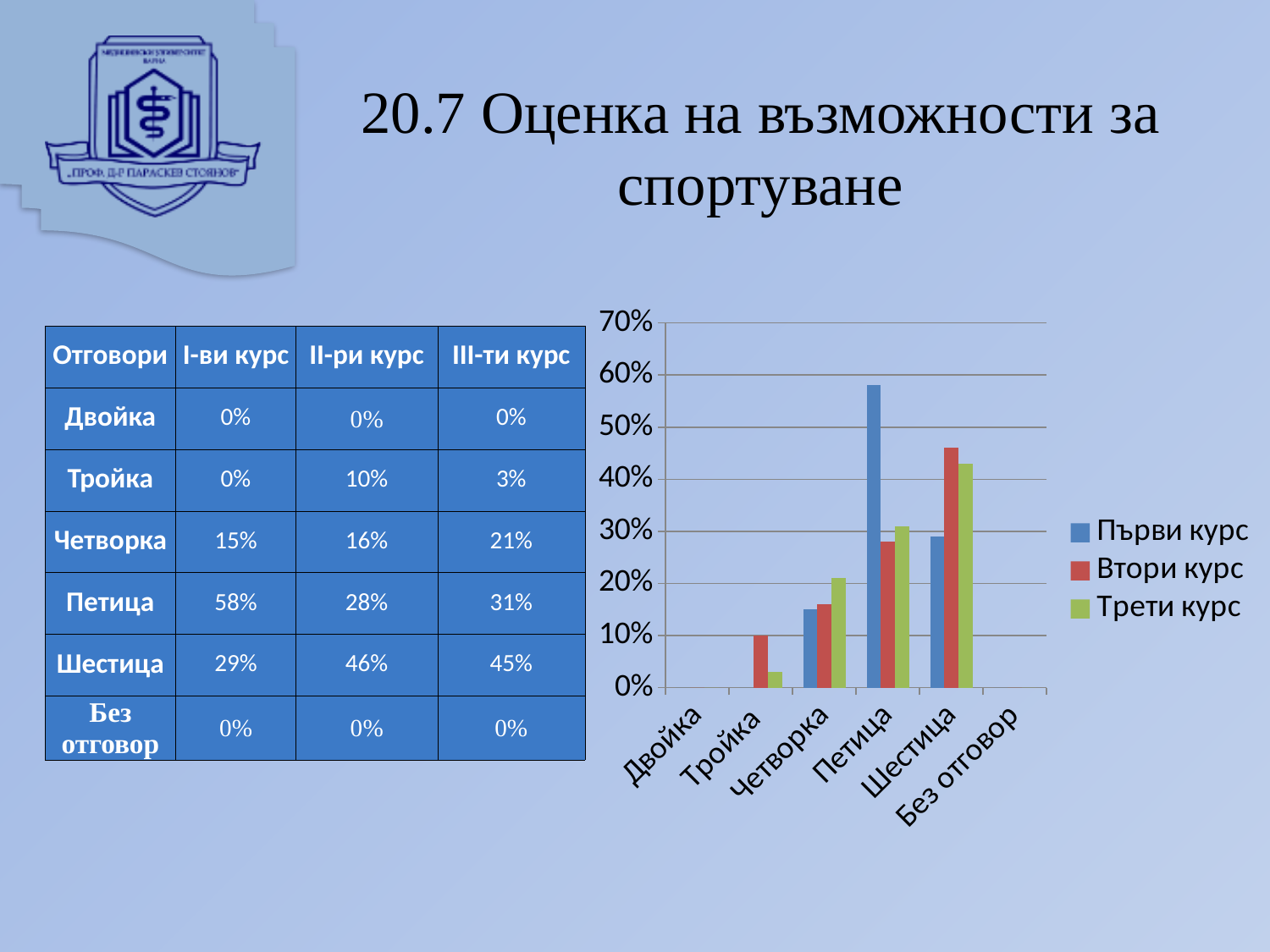
Is the value for Първи курс at Петица greater or less than 50%? greater What is the value for Първи курс at Петица, as printed in the table on the slide? 58% Which category has the highest value for the Втори курс series? Шестица How many categories are shown on the x axis of the chart? 6 What colour are the bars for the Трети курс series? green Which category has the highest value for the Първи курс series? Петица What kind of chart is shown on the slide? bar chart Is the value for Трети курс at Четворка greater or less than 30%? less How many series does the chart legend list? 3 For the category Шестица, which is larger: Първи курс or Втори курс? Втори курс What is the difference between the Втори курс and Първи курс values at Шестица, using the values printed in the table? 17% For the category Петица, which is larger: Втори курс or Трети курс? Трети курс